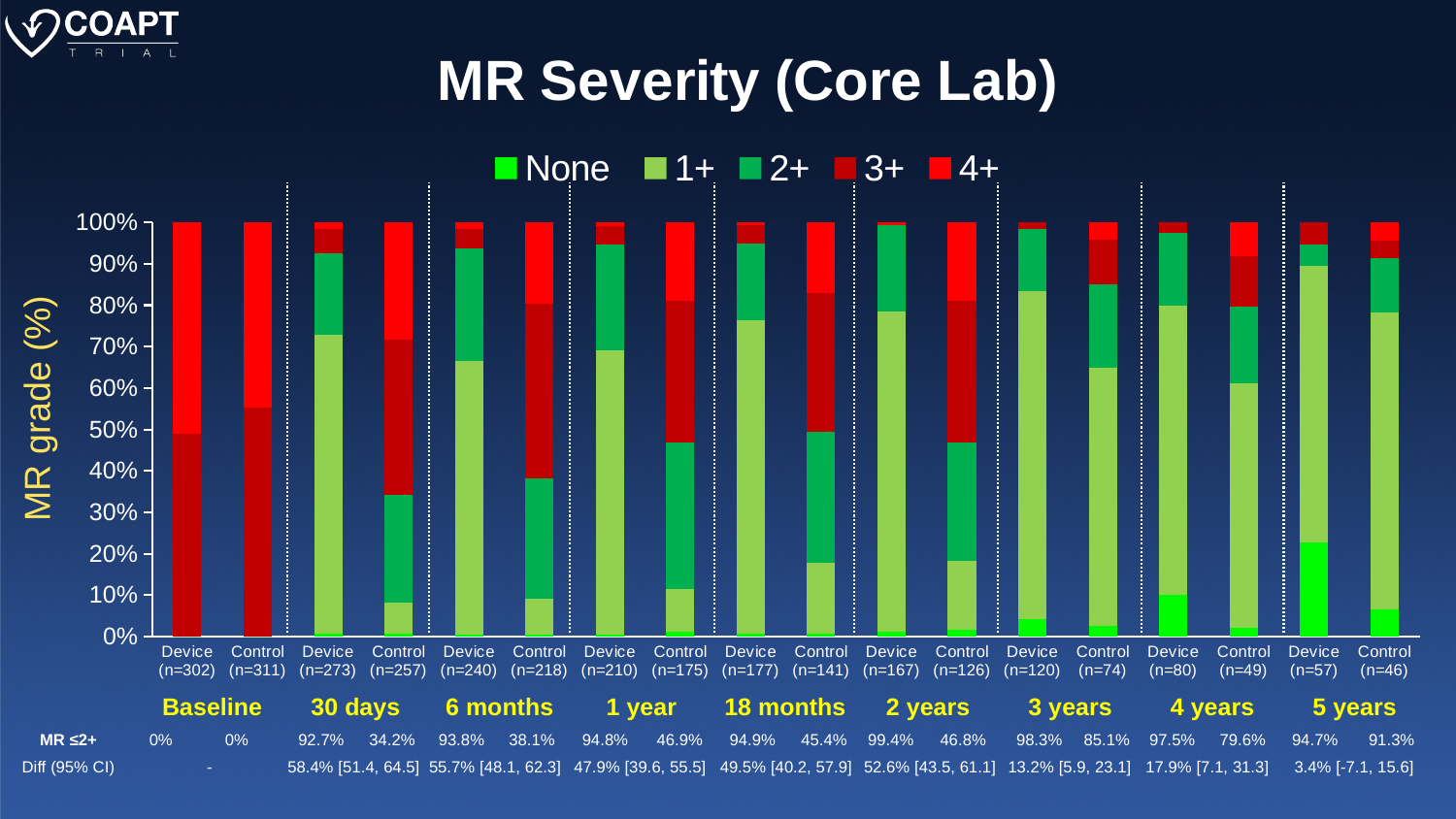
Is the 1+ segment for the Device bar at 2 years greater or less than 70%? greater What MR ≤2+ value is shown for the Control group at 3 years? 85.1% What is the difference between the Device and Control MR ≤2+ values at 4 years? 17.9% What is the title of the chart? MR Severity (Core Lab) What kind of chart is shown on the slide? Stacked bar chart What MR ≤2+ value is shown for the Device group at 30 days? 92.7% How many bars are plotted in the chart? 18 What is the Diff (95% CI) shown at 1 year? 47.9% [39.6, 55.5] At which time point is the Device MR ≤2+ value highest? 2 years How many series does the legend list? 5 At 6 months, which group has the higher MR ≤2+ value, Device or Control? Device At which follow-up time point (after baseline) is the Control MR ≤2+ value lowest? 30 days